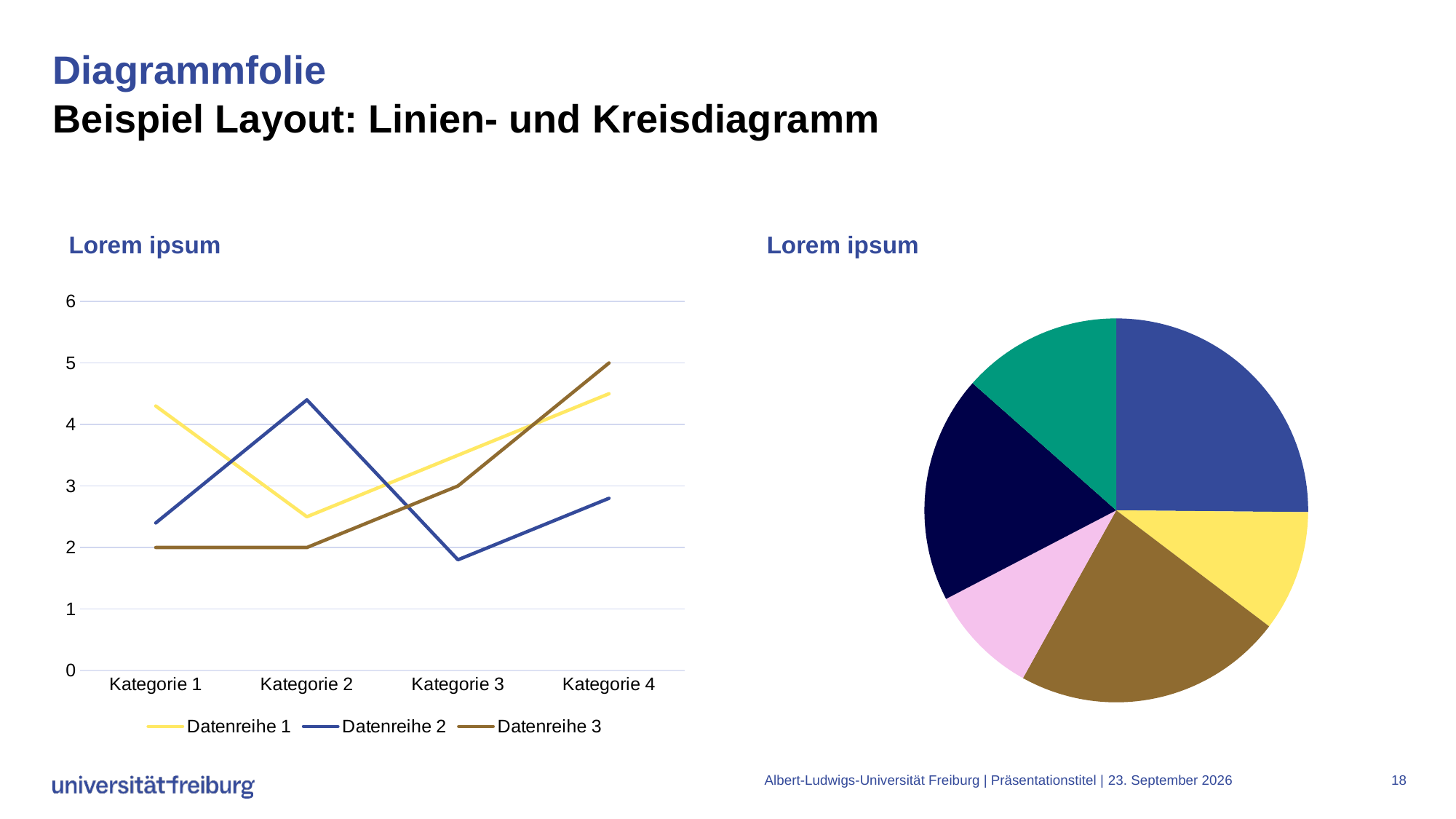
In the line chart on the left, is the value of Datenreihe 2 at Kategorie 3 greater or less than 2? less In the line chart on the left, how many categories are shown on the x axis? 4 In the line chart on the left, what is the value of Datenreihe 3 at Kategorie 1? 2 What kind of chart is the chart on the left of the slide? line chart In the line chart on the left, what is the value of Datenreihe 3 at Kategorie 4? 5 In the line chart on the left, at which category does Datenreihe 2 reach its lowest value? Kategorie 3 What kind of chart is the chart on the right of the slide? pie chart In the line chart on the left, is the value of Datenreihe 2 at Kategorie 2 greater or less than 4? greater How many slices does the pie chart on the right have? 6 In the line chart on the left, how many series does the legend list? 3 In the line chart on the left, does Datenreihe 3 rise or fall from Kategorie 2 to Kategorie 4? rise In the line chart on the left, which series has the higher value at Kategorie 4, Datenreihe 2 or Datenreihe 3? Datenreihe 3